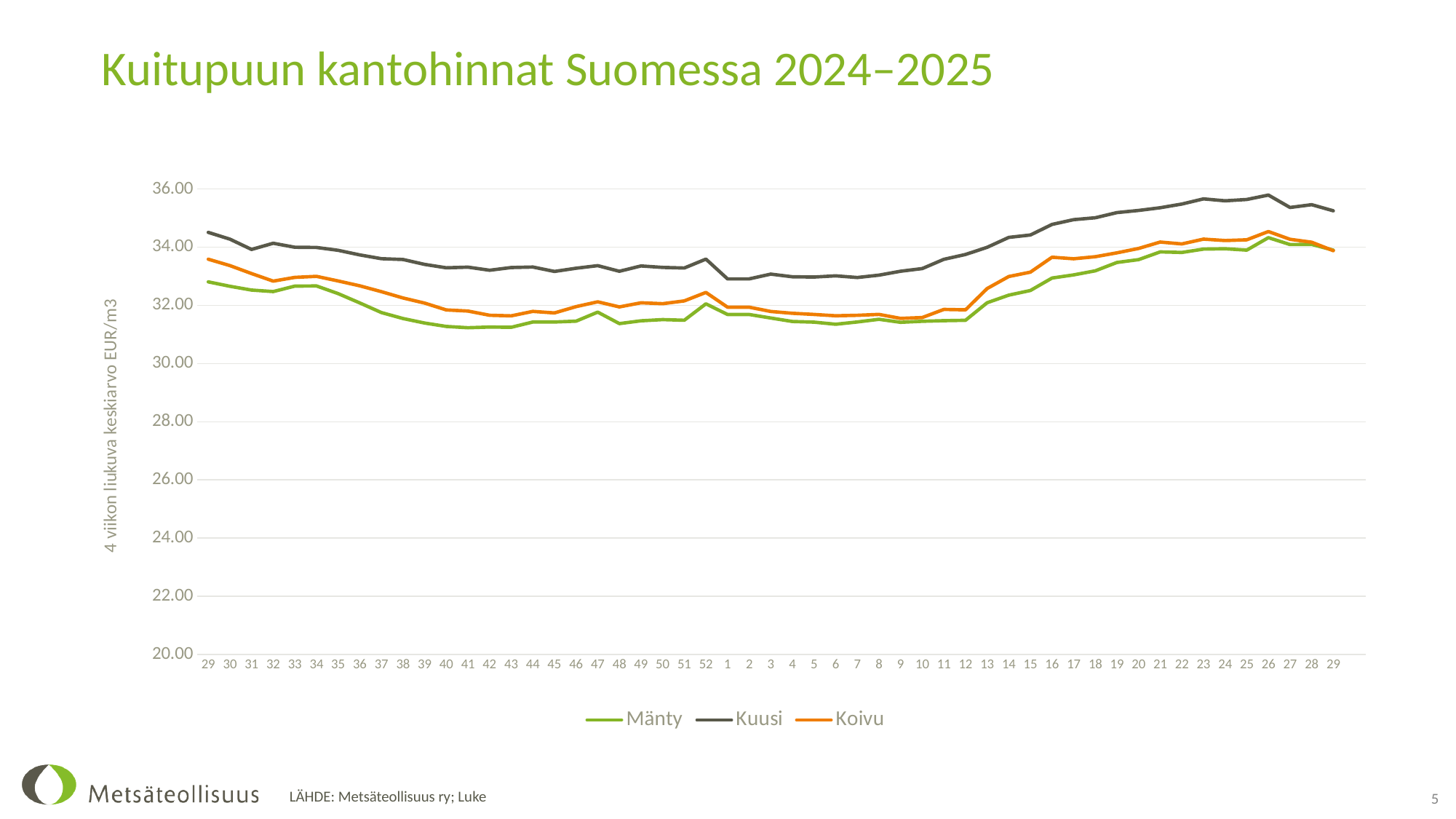
Is the value for Kuusi at week 26 greater or less than 36.00? less Is the value for Kuusi at the first week 29 greater or less than 34.00? greater Does the Kuusi line rise or fall from week 13 to week 26? rise Which series has the lowest value at week 41? Mänty What is the title of the chart? Kuitupuun kantohinnat Suomessa 2024–2025 Which series has the highest values across the whole chart? Kuusi At week 40, which is larger, Koivu or Mänty? Koivu What kind of chart is shown on the slide? line chart At week 26, which is larger, Kuusi or Koivu? Kuusi How many week points are plotted along the x axis? 53 Is the value for Mänty at week 41 greater or less than 32.00? less How many series does the legend list? 3